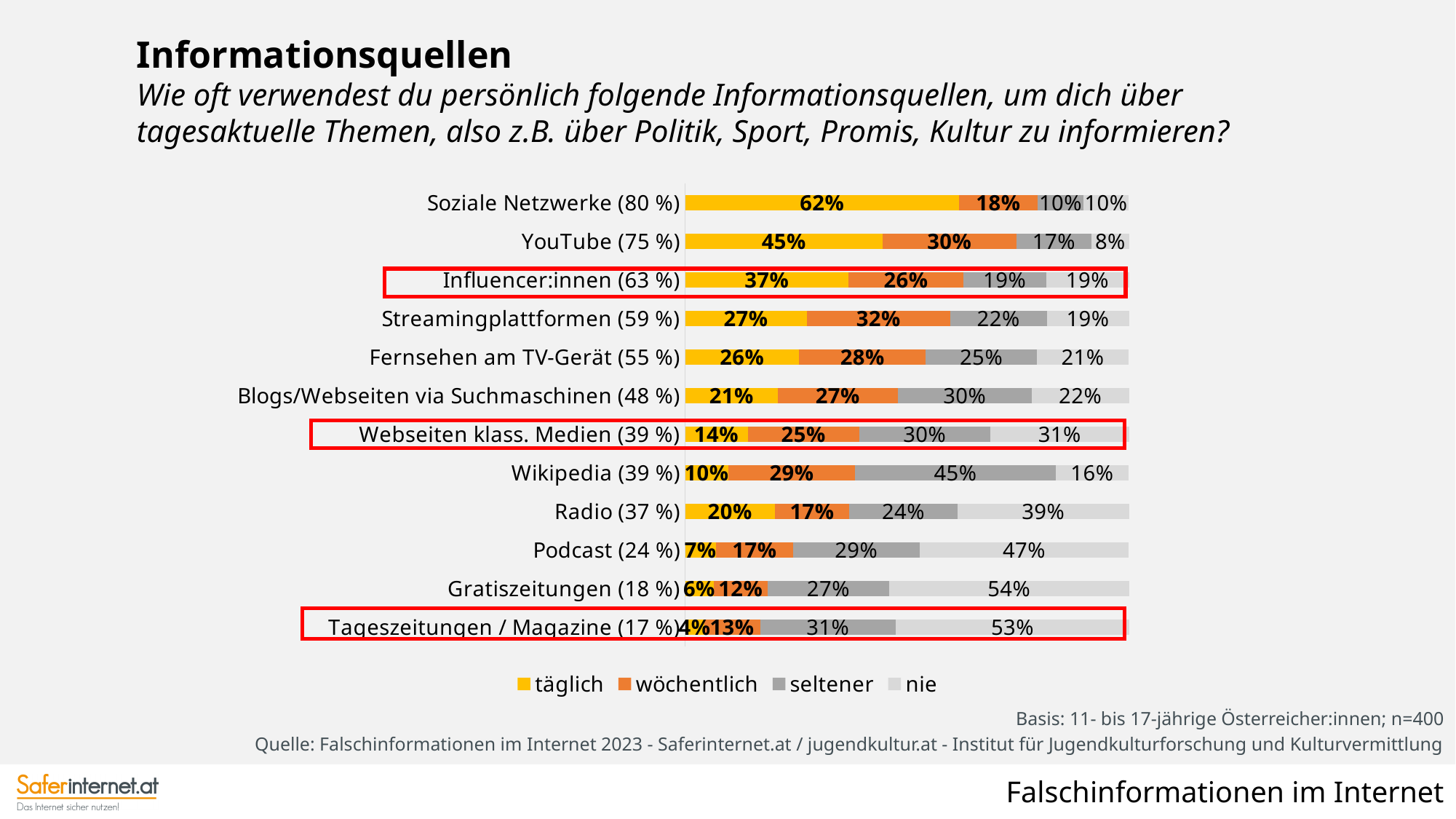
What percentage of respondents use Soziale Netzwerke täglich? 62% What is the 'nie' value for Radio? 39% How many series does the legend list? 4 Which information source has the highest 'täglich' value? Soziale Netzwerke (80 %) Which legend entry is shown in yellow? täglich How many information sources are listed in the chart? 12 What is the total of the four segments for the Soziale Netzwerke bar? 100% What is the 'wöchentlich' value for Streamingplattformen? 32% What type of chart is shown on the slide? Stacked bar chart Which has a larger 'seltener' value, Wikipedia or Blogs/Webseiten via Suchmaschinen? Wikipedia Which information source has the lowest 'täglich' value? Tageszeitungen / Magazine (17 %) How many percentage points higher is the 'wöchentlich' value for YouTube than for Soziale Netzwerke? 12